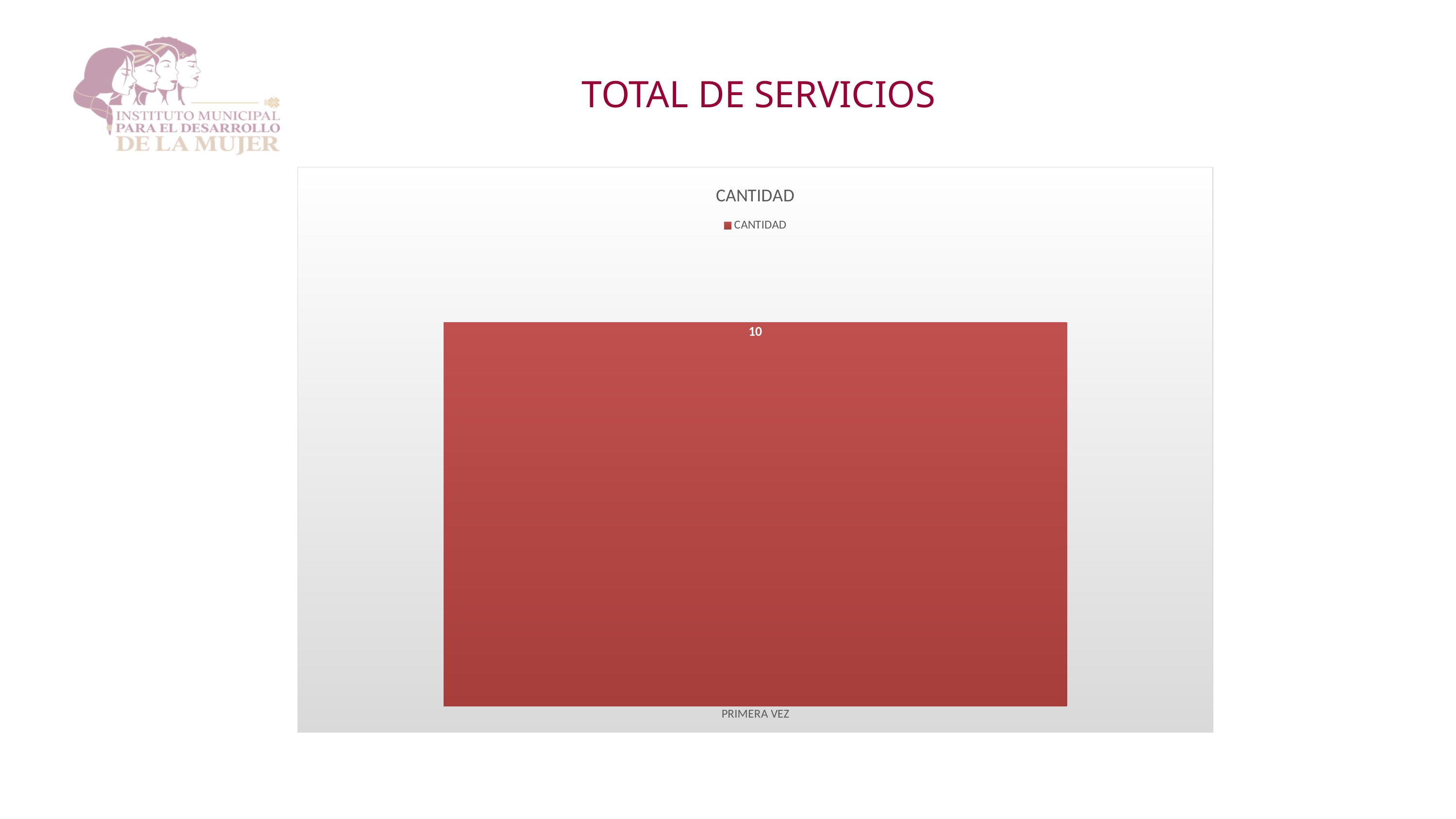
What is the label of the only category on the x axis? PRIMERA VEZ What kind of chart is shown on the slide? bar chart What is the title of the chart? CANTIDAD What is the value for PRIMERA VEZ? 10 What is the name of the series listed in the legend? CANTIDAD How many categories are shown on the x axis of the chart? 1 How many series does the legend list? 1